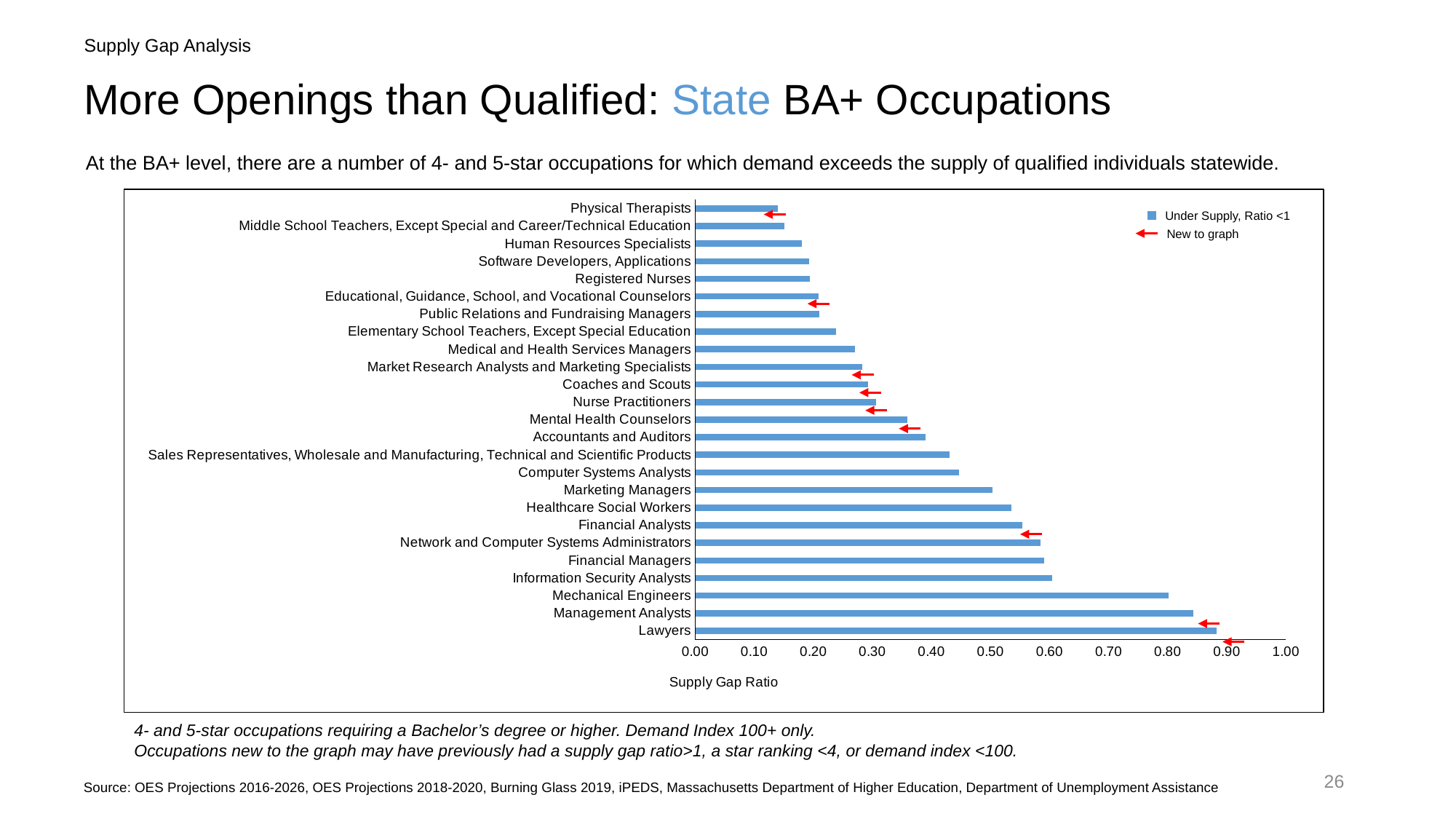
According to the legend, what does a red arrow next to a bar indicate? New to graph What kind of chart is shown on the slide? bar chart What is the title of the horizontal axis of the chart? Supply Gap Ratio Is the supply gap ratio for Medical and Health Services Managers greater or less than 0.30? less How many occupations are plotted in the chart? 25 Is the supply gap ratio for Computer Systems Analysts greater or less than 0.40? greater Which occupation has the highest supply gap ratio? Lawyers Which has a larger supply gap ratio, Mechanical Engineers or Information Security Analysts? Mechanical Engineers Is the supply gap ratio for Management Analysts greater or less than 0.80? greater